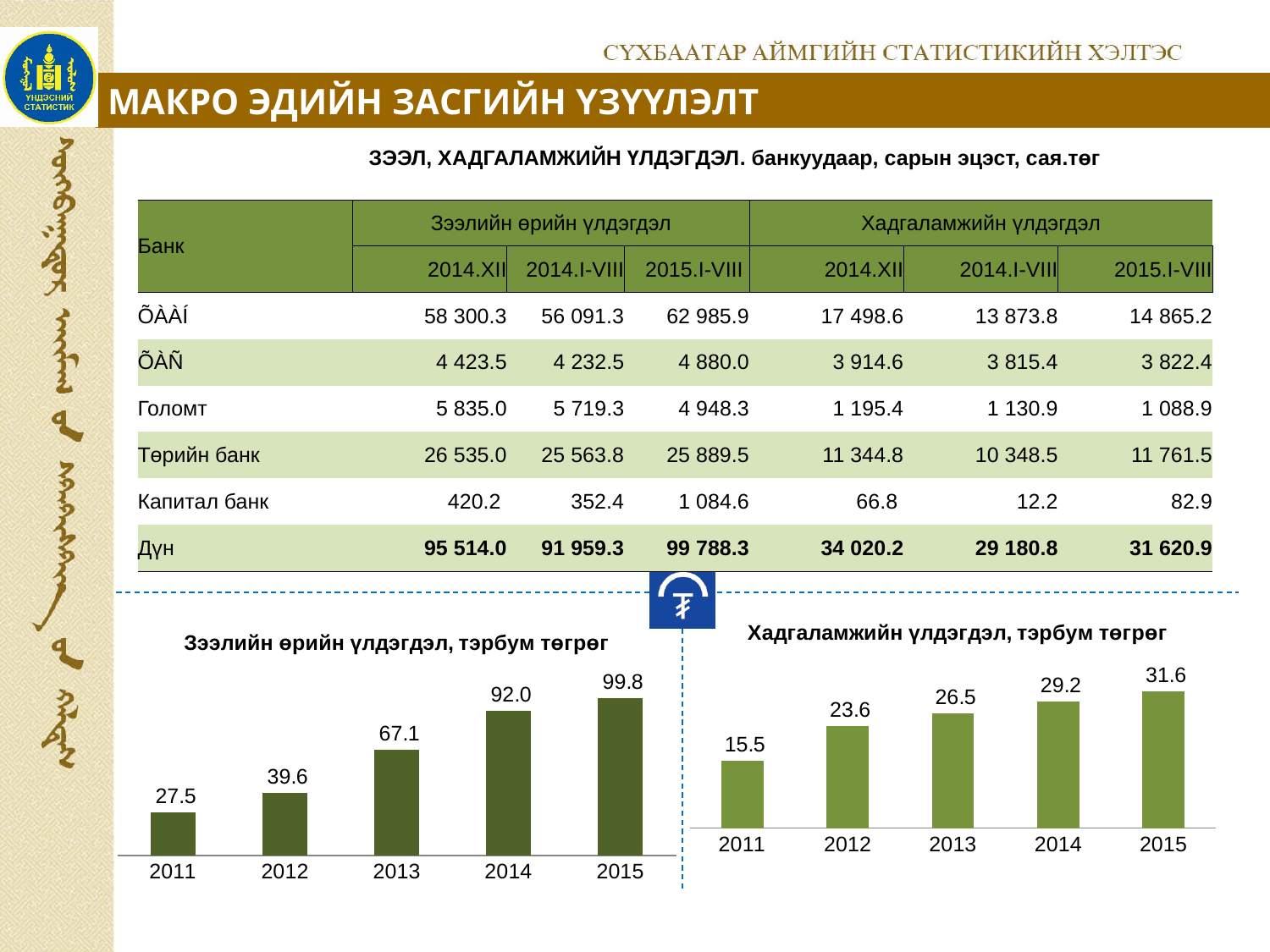
In the chart titled "Хадгаламжийн үлдэгдэл, тэрбум төгрөг", which year has the lowest value? 2011 In the chart titled "Хадгаламжийн үлдэгдэл, тэрбум төгрөг", what is the difference between the values for 2013 and 2012? 2.9 In the chart titled "Хадгаламжийн үлдэгдэл, тэрбум төгрөг", what is the value for 2015? 31.6 In the chart titled "Хадгаламжийн үлдэгдэл, тэрбум төгрөг", what is the value for 2012? 23.6 What kind of chart is the chart titled "Хадгаламжийн үлдэгдэл, тэрбум төгрөг"? bar chart In the chart titled "Зээлийн өрийн үлдэгдэл, тэрбум төгрөг", how many years are shown? 5 In the chart titled "Зээлийн өрийн үлдэгдэл, тэрбум төгрөг", what is the value for 2013? 67.1 In the chart titled "Зээлийн өрийн үлдэгдэл, тэрбум төгрөг", do the values rise or fall from 2011 to 2015? rise In the chart titled "Хадгаламжийн үлдэгдэл, тэрбум төгрөг", which is larger, the value for 2014 or the value for 2013? 2014 In the chart titled "Зээлийн өрийн үлдэгдэл, тэрбум төгрөг", what is the difference between the values for 2015 and 2014? 7.8 In the chart titled "Зээлийн өрийн үлдэгдэл, тэрбум төгрөг", what is the value for 2011? 27.5 In the chart titled "Зээлийн өрийн үлдэгдэл, тэрбум төгрөг", which year has the highest value? 2015